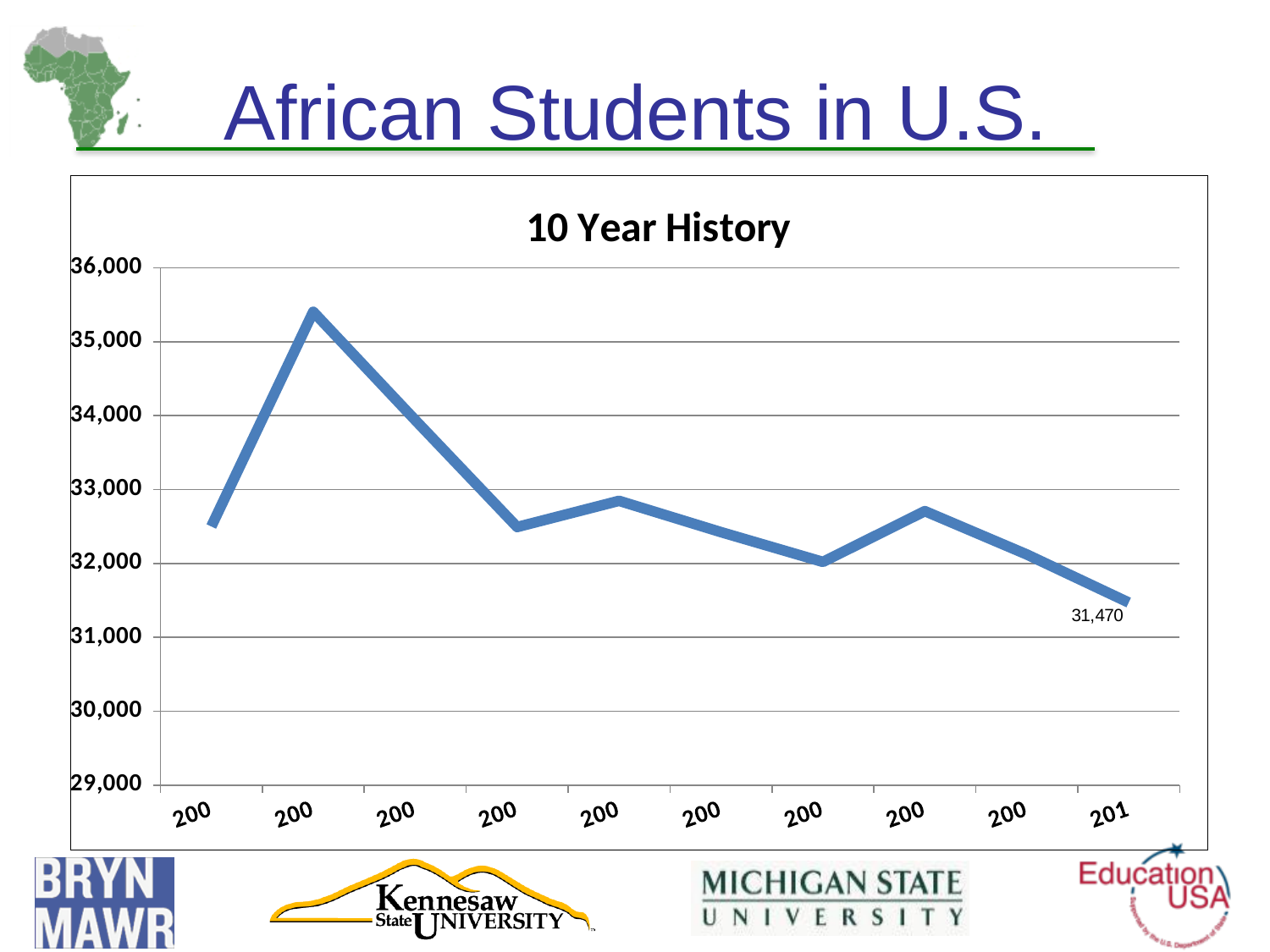
What kind of chart is shown on the slide? line chart Is the value at the second point of the line greater or less than 35,000? greater How many data points are plotted on the line? 10 Is the value at the last point of the line greater or less than 32,000? less Is the value at the first point of the line greater or less than 32,000? greater What value is printed as the data label on the last point of the line? 31,470 What is the title of the chart? 10 Year History At which point along the x axis does the line reach its highest value? the second point After its peak at the second point, does the line generally rise or fall toward the right? fall What is the highest value shown on the y axis? 36,000 Which is larger, the value at the first point or the value at the last point of the line? the first point